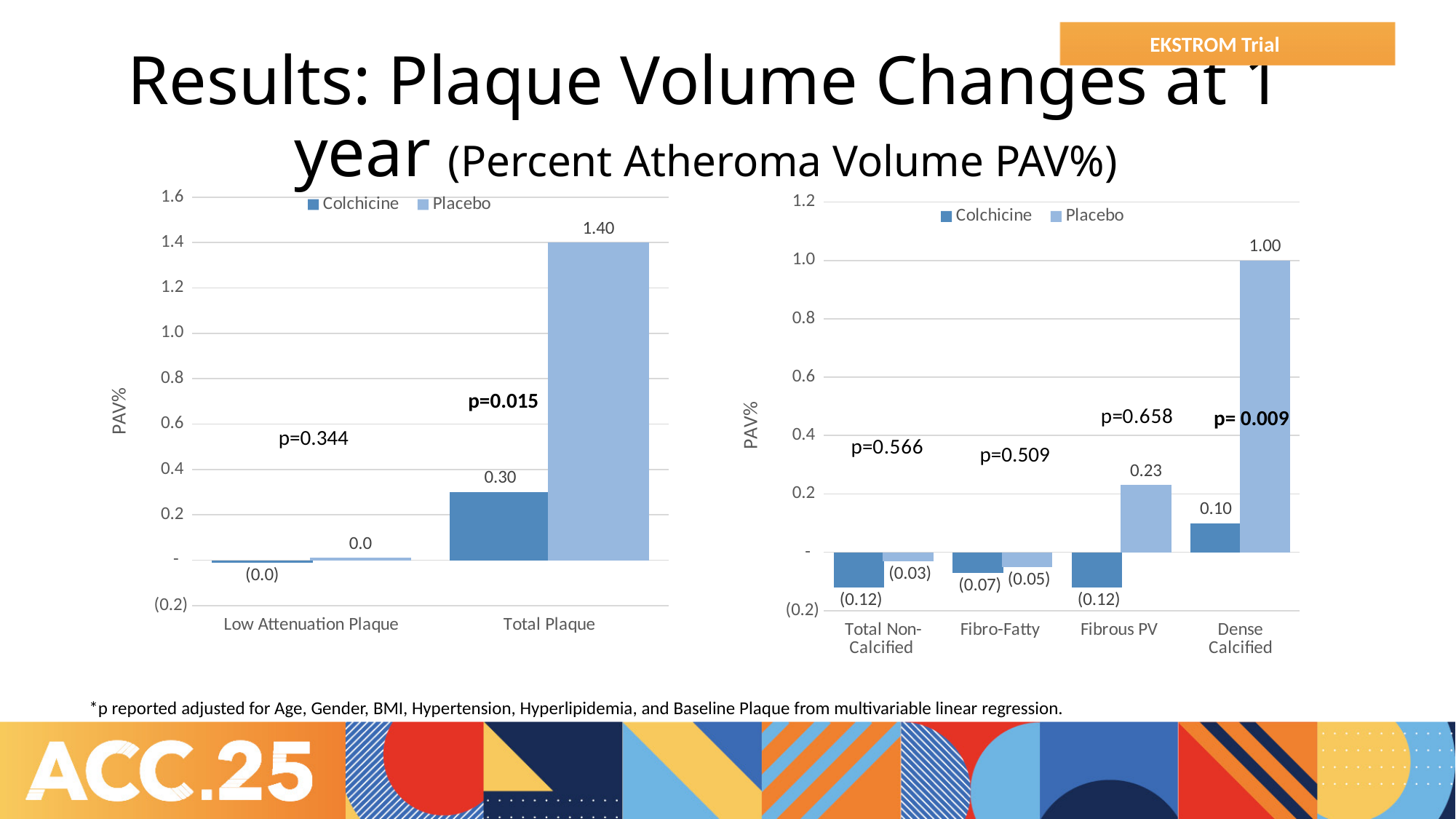
In the right chart, what is the Placebo value for Fibro-Fatty? (0.05) In the left chart, what is the Placebo value for Total Plaque? 1.40 How many series does the legend of the right chart list? 2 In the right chart, which category has the highest Placebo value? Dense Calcified In the right chart, which is larger for Fibrous PV, the Colchicine value or the Placebo value? Placebo In the left chart, what is the difference between the Placebo and Colchicine values for Total Plaque? 1.10 What kind of chart is the left chart? Bar chart In the left chart, what is the Colchicine value for Total Plaque? 0.30 In the left chart, how many categories are shown on the x axis? 2 In the right chart, what is the Placebo value for Dense Calcified? 1.00 In the right chart, what is the Colchicine value for Fibrous PV? (0.12) In the right chart, how many categories are shown on the x axis? 4